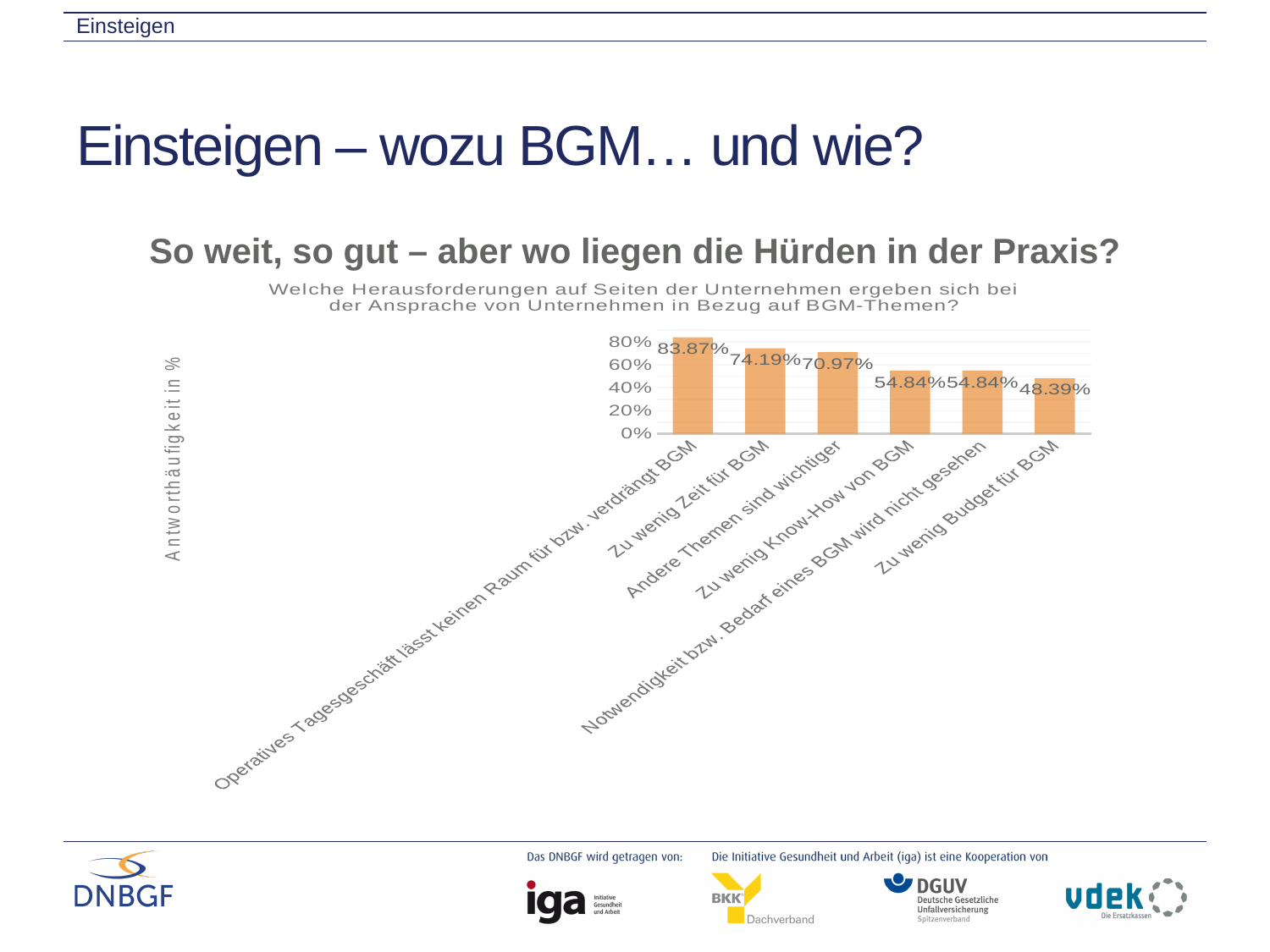
Which category has the highest value? Operatives Tagesgeschäft lässt keinen Raum für bzw. verdrängt BGM What is the label of the vertical axis of the chart? Antworthäufigkeit in % Is the value for "Zu wenig Budget für BGM" greater or less than 60%? less How many categories are shown in the chart? 6 What kind of chart is shown on the slide? bar chart What is the value for "Zu wenig Budget für BGM"? 48.39% Which category has the lowest value? Zu wenig Budget für BGM What is the value for "Andere Themen sind wichtiger"? 70.97% Which is larger, the value for "Zu wenig Zeit für BGM" or for "Andere Themen sind wichtiger"? Zu wenig Zeit für BGM What is the value for "Zu wenig Zeit für BGM"? 74.19% What is the difference between the values for "Operatives Tagesgeschäft lässt keinen Raum für bzw. verdrängt BGM" and "Zu wenig Budget für BGM"? 35.48% Do the values rise or fall from left to right along the x axis? fall